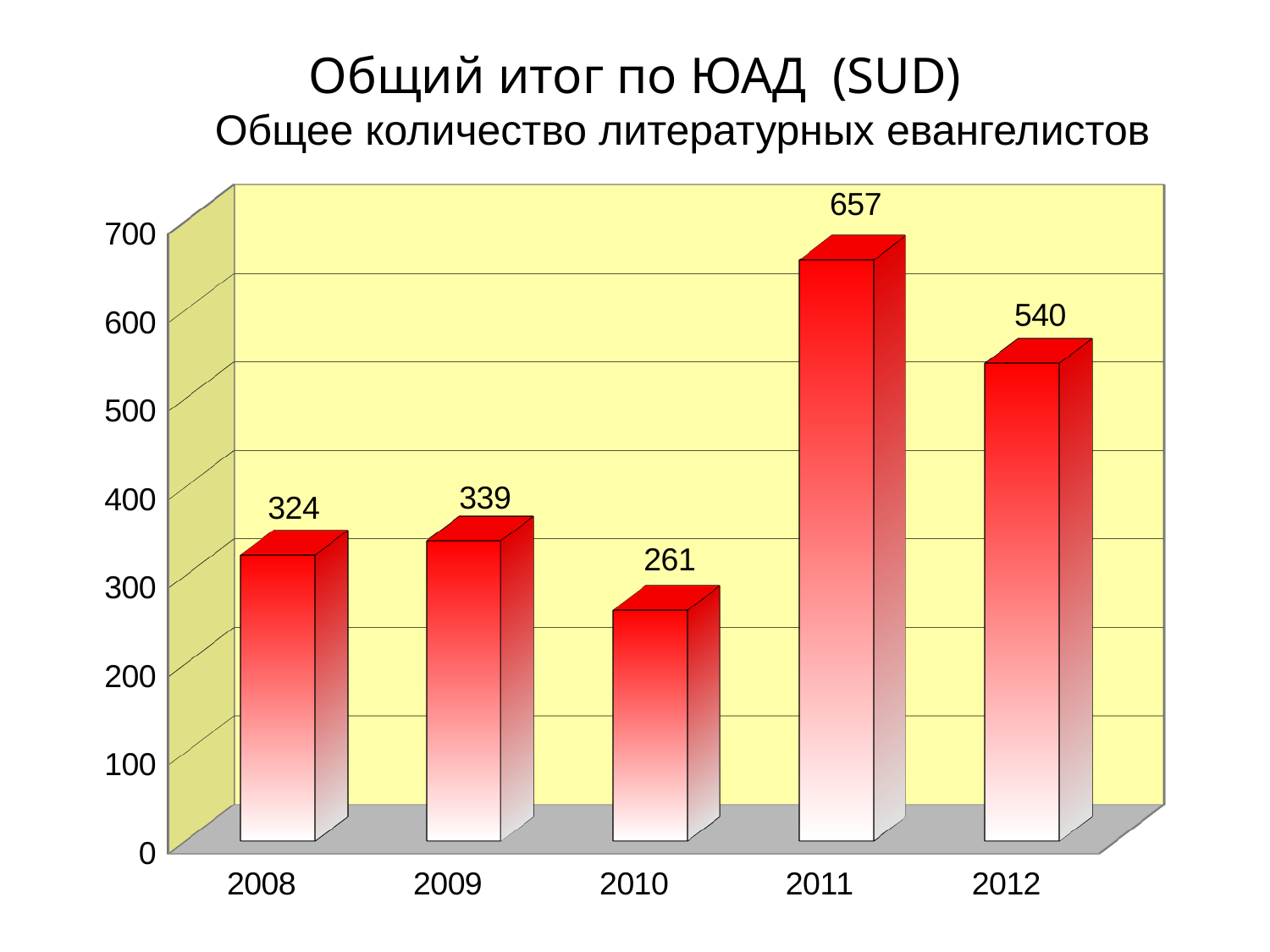
What is the value for 2011? 657 What kind of chart is shown on the slide? bar chart Do the values rise or fall from 2011 to 2012? fall Which is larger, the value for 2009 or the value for 2010? 2009 Which year has the highest value? 2011 What is the value for 2008? 324 What is the difference between the values for 2011 and 2012? 117 How many years are shown on the x axis? 5 What is the value for 2010? 261 Which year has the lowest value? 2010 Is the value for 2012 greater or less than 500? greater What is the difference between the values for 2009 and 2008? 15